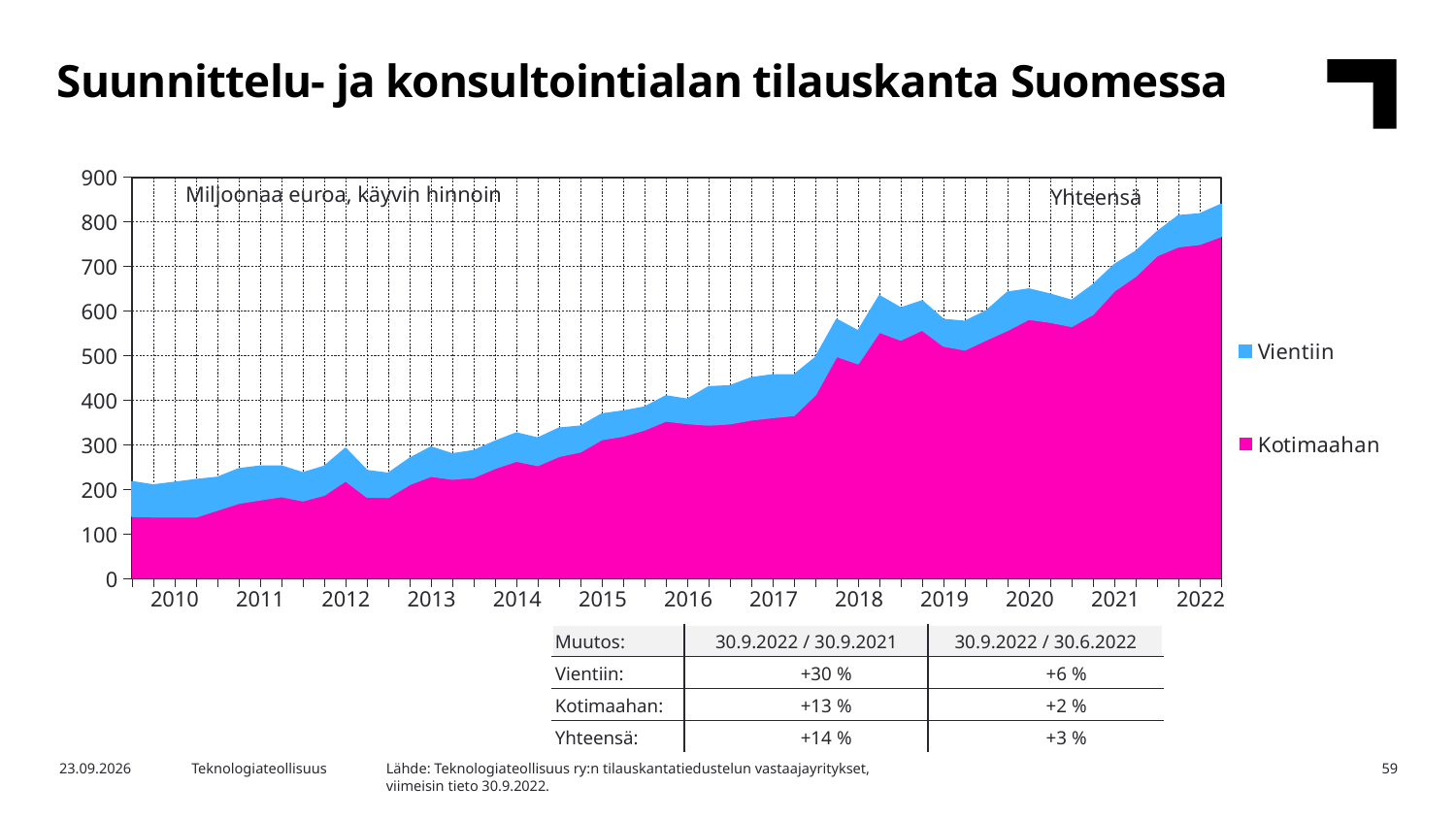
Is the Kotimaahan value at the end of 2022 greater or less than 700? greater Does the total order backlog (Yhteensä) generally rise or fall from 2010 to 2022? Rise Which series, Vientiin or Kotimaahan, has the larger values throughout the chart? Kotimaahan In which year does the total order backlog reach its highest level? 2022 Is the total order backlog at the end of 2022 greater or less than 800? greater What unit is stated in the chart's annotation text? Miljoonaa euroa, käyvin hinnoin How many series does the chart legend list? 2 How many years are labelled on the x axis of the chart? 13 In which year is the total order backlog at its lowest level? 2010 What are the two series named in the chart legend? Vientiin and Kotimaahan What kind of chart is shown on the slide? Stacked area chart Is the total order backlog at the start of 2010 greater or less than 300? less